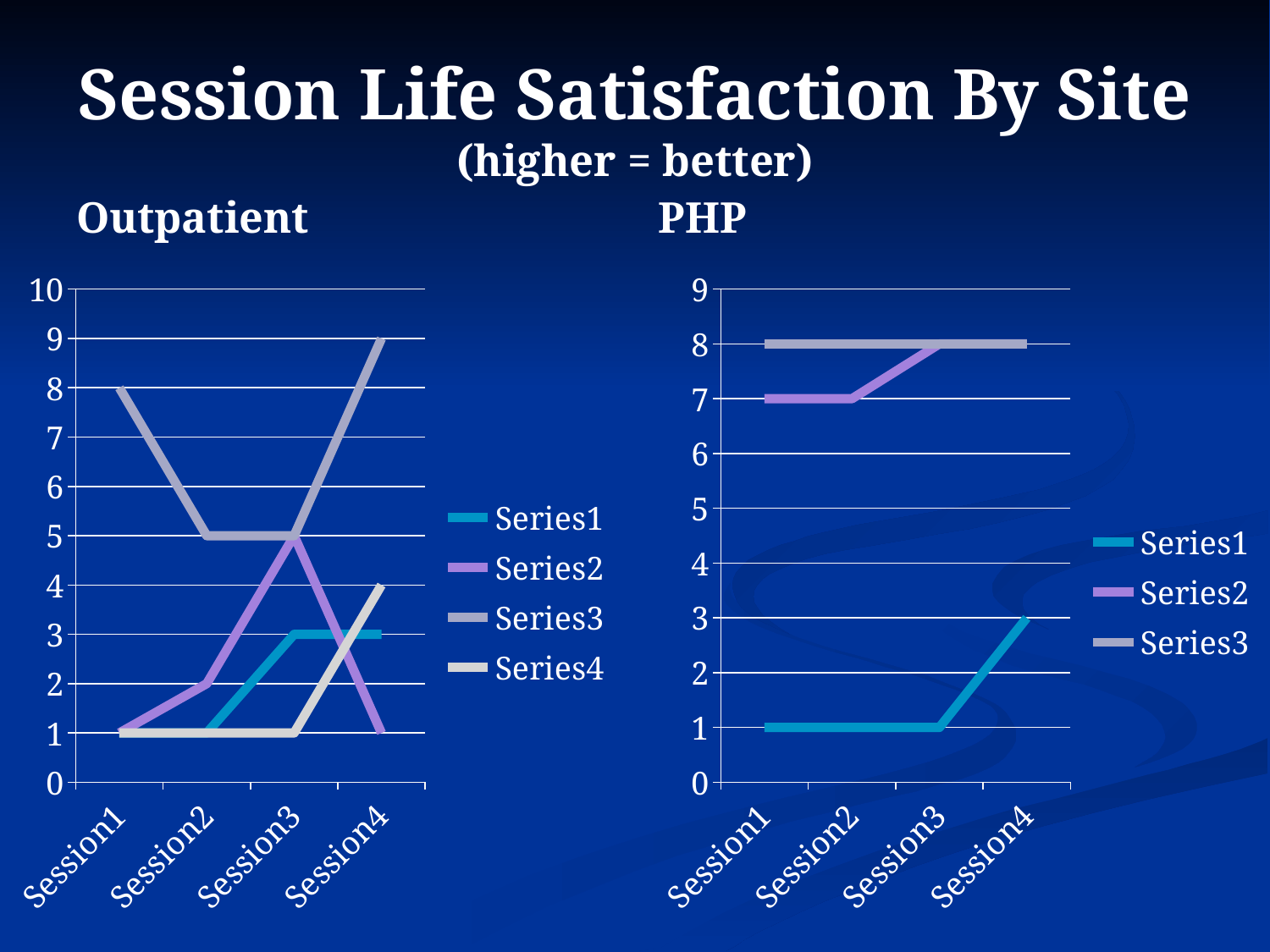
How many sessions are shown on the x axis of the PHP chart? 4 In the Outpatient chart, what is the difference between Series3 and Series1 at Session1? 7 In the PHP chart, does Series1 rise or fall from Session3 to Session4? rise How many series does the legend of the PHP chart list? 3 In the Outpatient chart, what is the value of Series2 at Session3? 5 In the Outpatient chart, which series has the lowest value at Session4? Series2 In the PHP chart, what is the value of Series1 at Session4? 3 In the PHP chart, which series has the highest value at Session1? Series3 What type of chart is the Outpatient chart? line chart In the Outpatient chart, is the value of Series3 at Session1 greater or less than Series2 at Session1? greater In the Outpatient chart, what is the value of Series3 at Session4? 9 How many series does the legend of the Outpatient chart list? 4